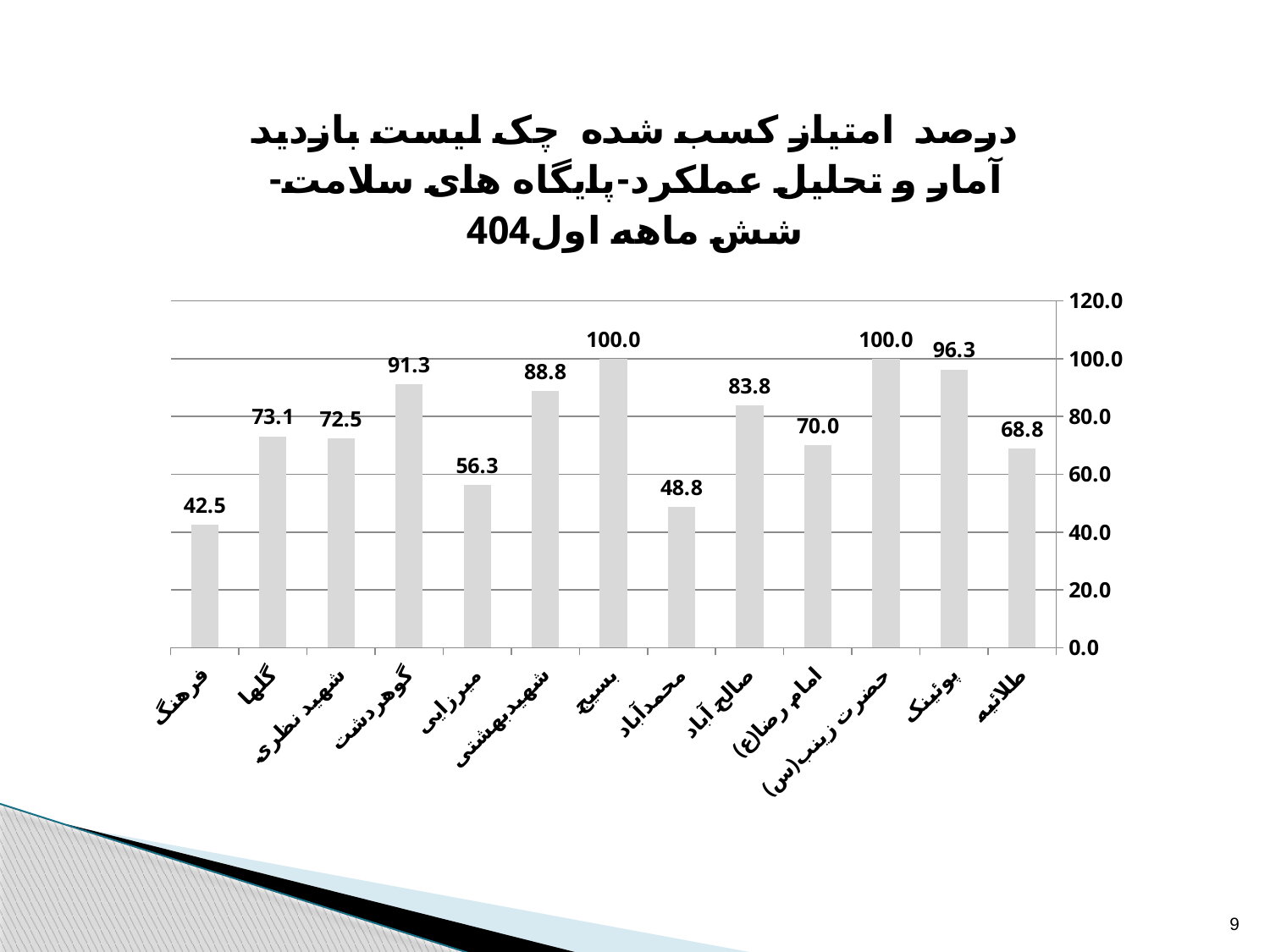
Which categories have the highest value? بسیج and حضرت زینب(س) How many categories are shown on the x axis? 13 What is the difference between the values for صالح آباد and امام رضا(ع)? 13.8 What type of chart is shown on the slide? bar chart What is the value for گوهردشت? 91.3 Which is larger, the value for میرزایی or the value for شهیدبهشتی? شهیدبهشتی What is the difference between the values for گلها and شهید نظری? 0.6 Is the value for طلائیه greater or less than 60.0? greater Which category has the lowest value? فرهنگ What is the value for فرهنگ? 42.5 What is the value for محمدآباد? 48.8